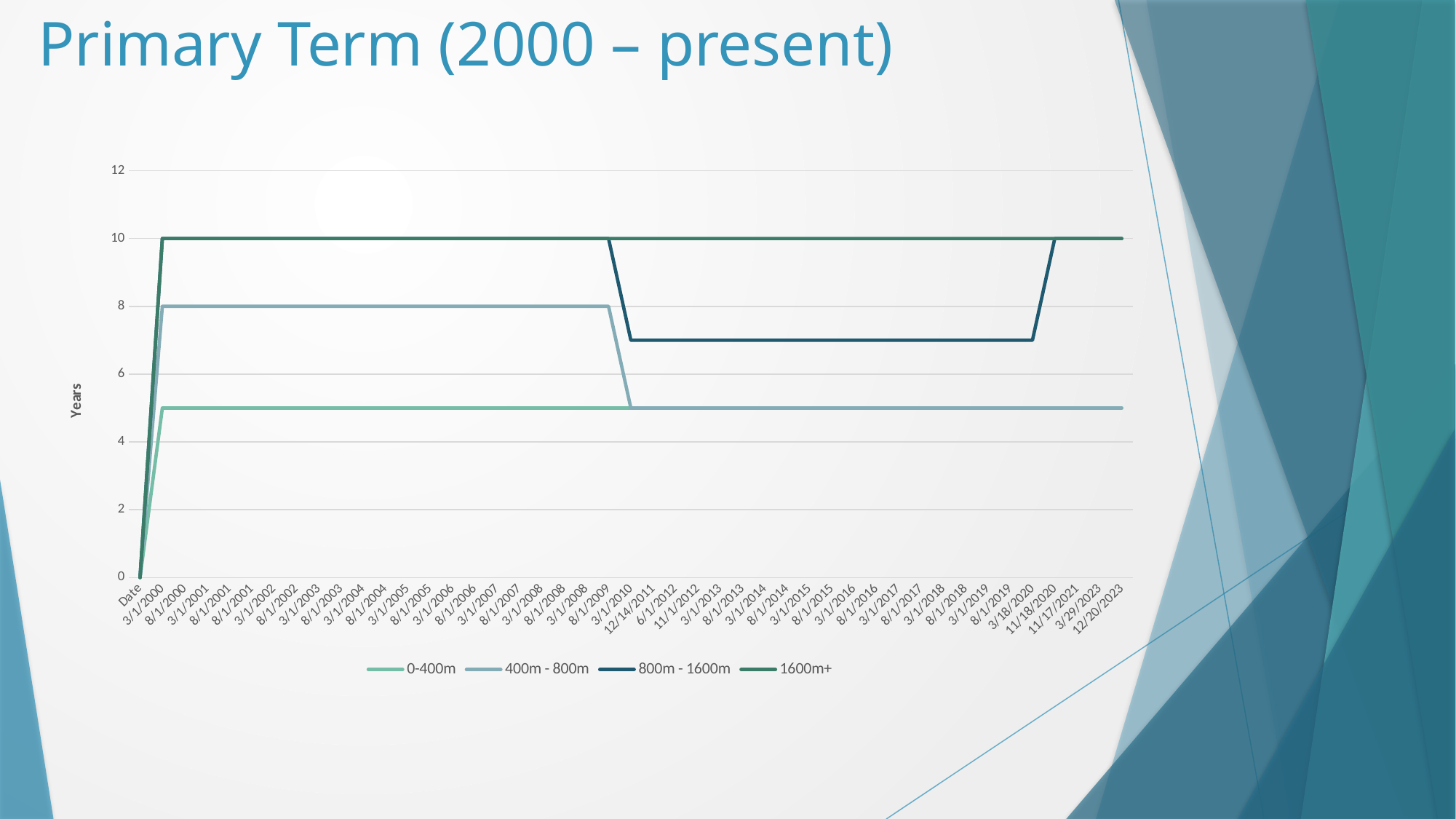
What is the value for the 800m - 1600m series at 3/1/2005? 10 Is the value for the 0-400m series at 3/1/2005 greater or less than 6? less What is the title of the chart on the slide? Primary Term (2000 – present) Which series has the highest value at 3/1/2015? 1600m+ What is the value for the 400m - 800m series at 3/1/2005? 8 How many series does the legend list? 4 What kind of chart is shown on the slide? line chart Which is larger at 3/1/2005, the value for 400m - 800m or the value for 0-400m? 400m - 800m What is the label of the vertical axis? Years What is the value for the 1600m+ series at 3/1/2005? 10 Is the value for the 800m - 1600m series at 3/1/2015 greater or less than 8? less Is the value for the 400m - 800m series at 3/1/2015 greater or less than 6? less